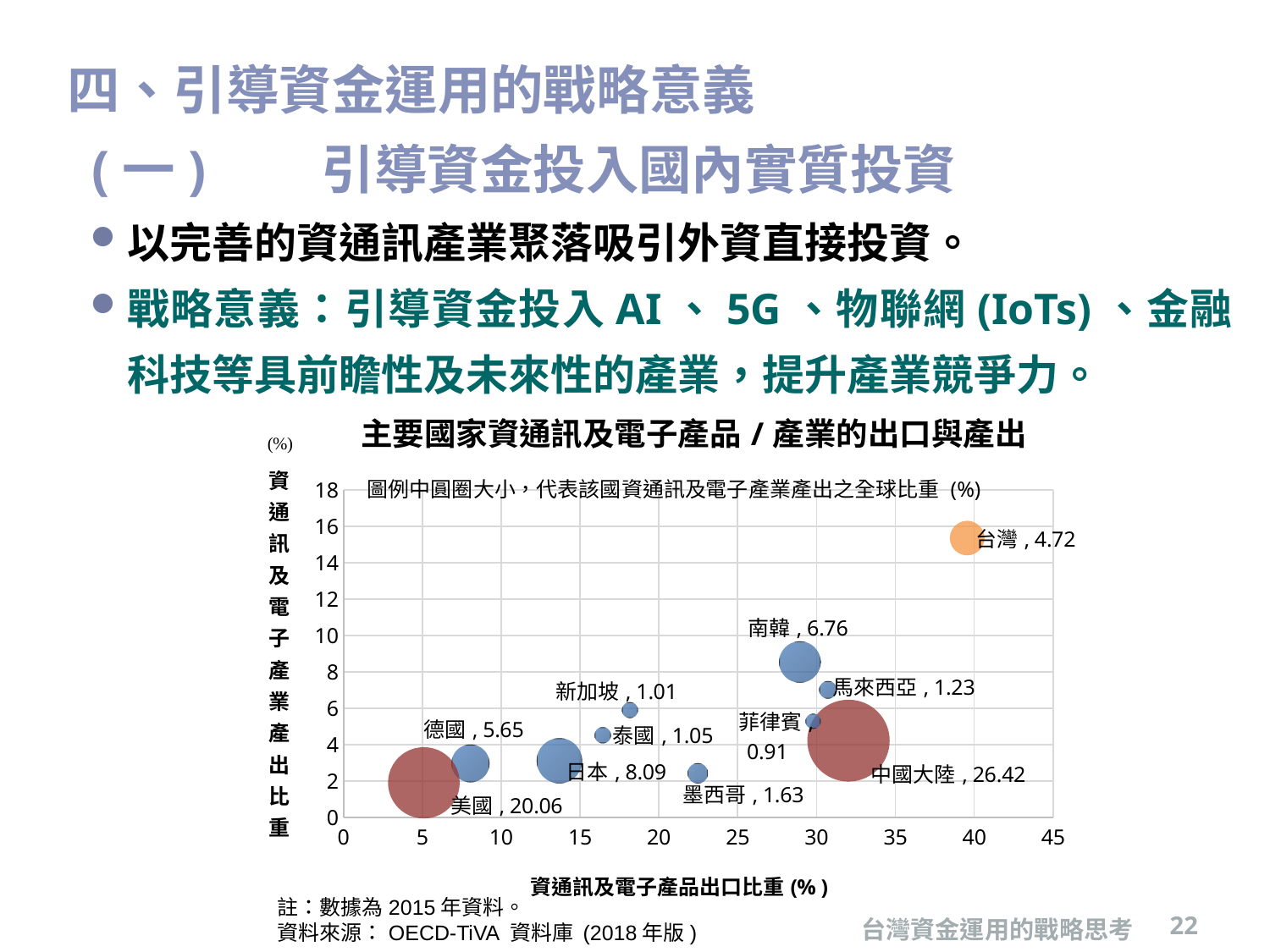
Is the horizontal-axis value (資通訊及電子產品出口比重) for 美國 greater or less than 10? less Is the vertical-axis value (資通訊及電子產業產出比重) for 台灣 greater or less than 14? greater What is the value shown in the data label for 日本? 8.09 What is the value shown in the data label for 台灣? 4.72 Which country has the smallest labelled value (bubble size) in the chart? 菲律賓 How many countries/regions are plotted as bubbles in the chart? 11 Which has the larger labelled value, 德國 or 台灣? 德國 What kind of chart is shown on the slide? bubble chart Which country has the largest labelled value (bubble size) in the chart? 中國大陸 What is the title of the chart? 主要國家資通訊及電子產品／產業的出口與產出 What is the difference between the labelled values for 中國大陸 and 美國? 6.36 What is the value shown in the data label for 南韓? 6.76